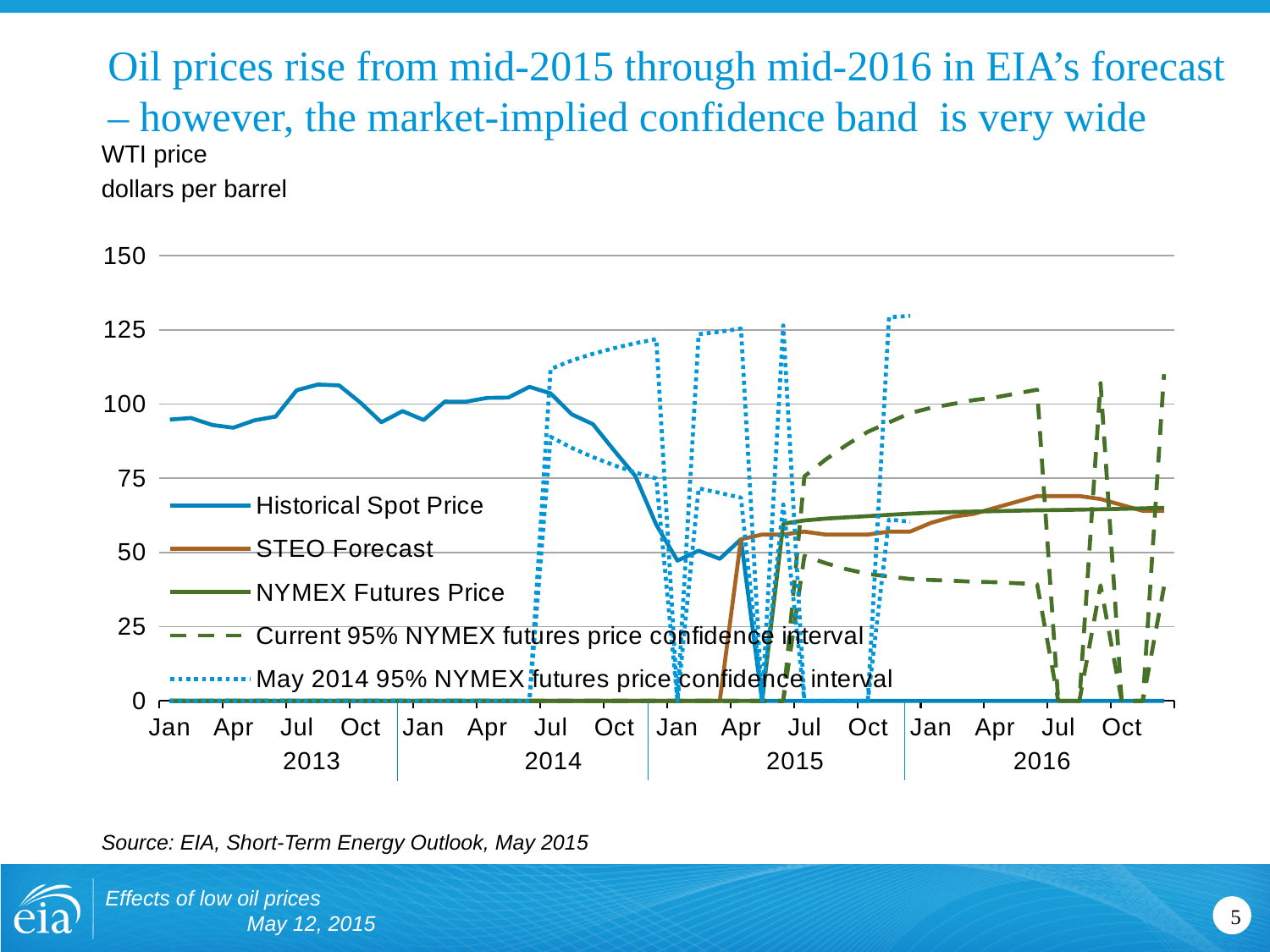
Does the Historical Spot Price rise or fall between Jul 2014 and Jan 2015? fall What kind of chart is shown on the slide? line chart What unit is the WTI price plotted in, according to the axis label? dollars per barrel Is the NYMEX Futures Price in Oct 2016 greater or less than 75? less Which is larger: the Historical Spot Price in Jan 2013 or in Jan 2015? Jan 2013 Is the Historical Spot Price in Jan 2013 greater or less than 75? greater What is the highest value shown on the vertical axis? 150 How many series does the chart legend list? 5 Is the Historical Spot Price in Jul 2014 greater or less than 100? greater Does the STEO Forecast rise or fall between Apr 2015 and Jul 2016? rise